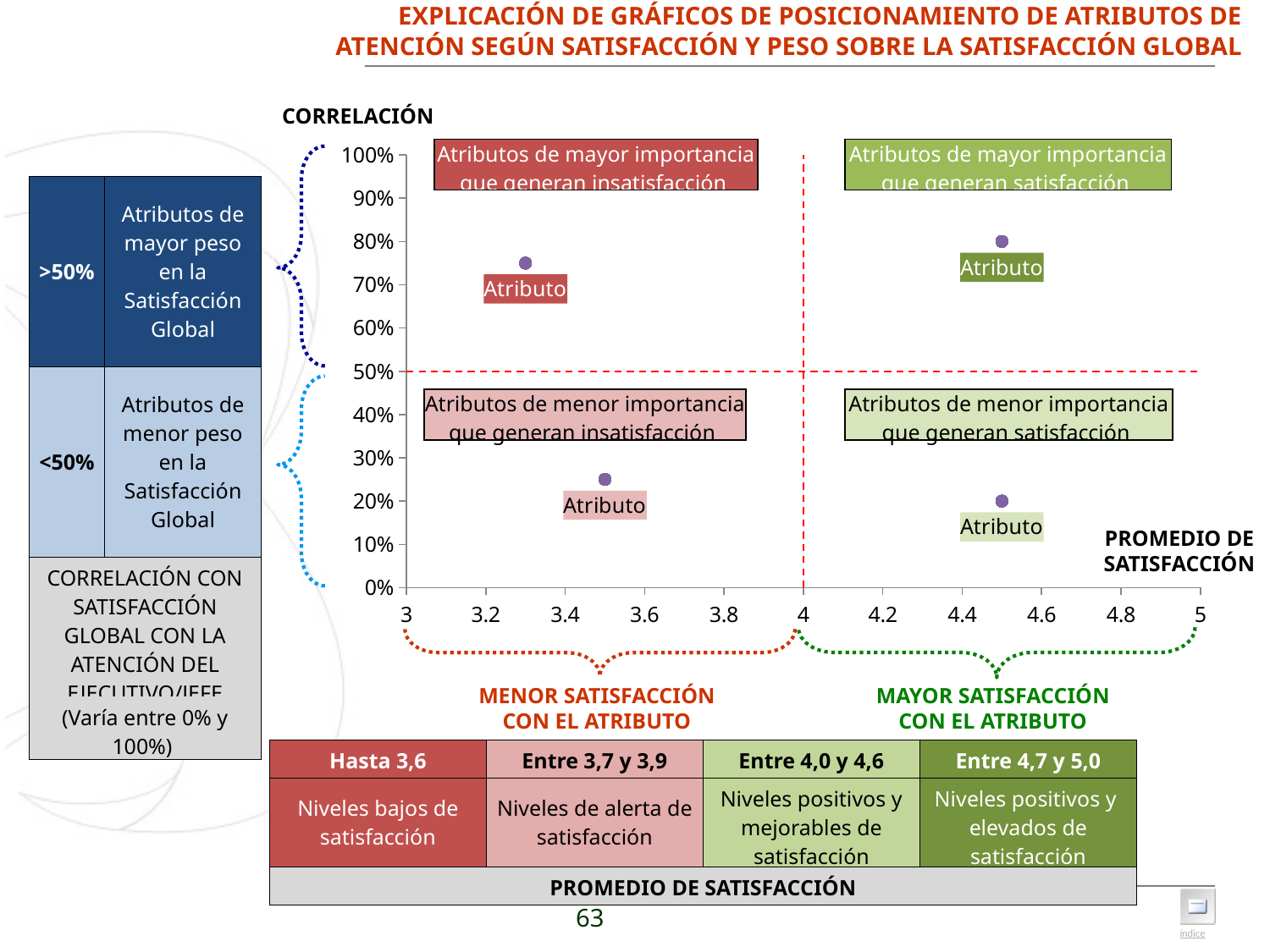
Is the satisfaction average (x value) of the point in the 'Atributos de menor importancia que generan satisfacción' quadrant greater or less than 4? greater How many data points are plotted on the chart? 4 What is the label of the horizontal axis of the chart? PROMEDIO DE SATISFACCIÓN What kind of chart is shown on the slide? scatter chart Is the correlation value of the point in the 'Atributos de mayor importancia que generan satisfacción' quadrant greater or less than 50%? greater Is the correlation value of the point in the 'Atributos de menor importancia que generan insatisfacción' quadrant greater or less than 50%? less Which point has the higher correlation: the one in the 'Atributos de mayor importancia que generan insatisfacción' quadrant or the one in the 'Atributos de menor importancia que generan insatisfacción' quadrant? Atributos de mayor importancia que generan insatisfacción What is the highest value shown on the horizontal axis of the chart? 5 At what correlation value is the horizontal dashed red line drawn on the chart? 50%